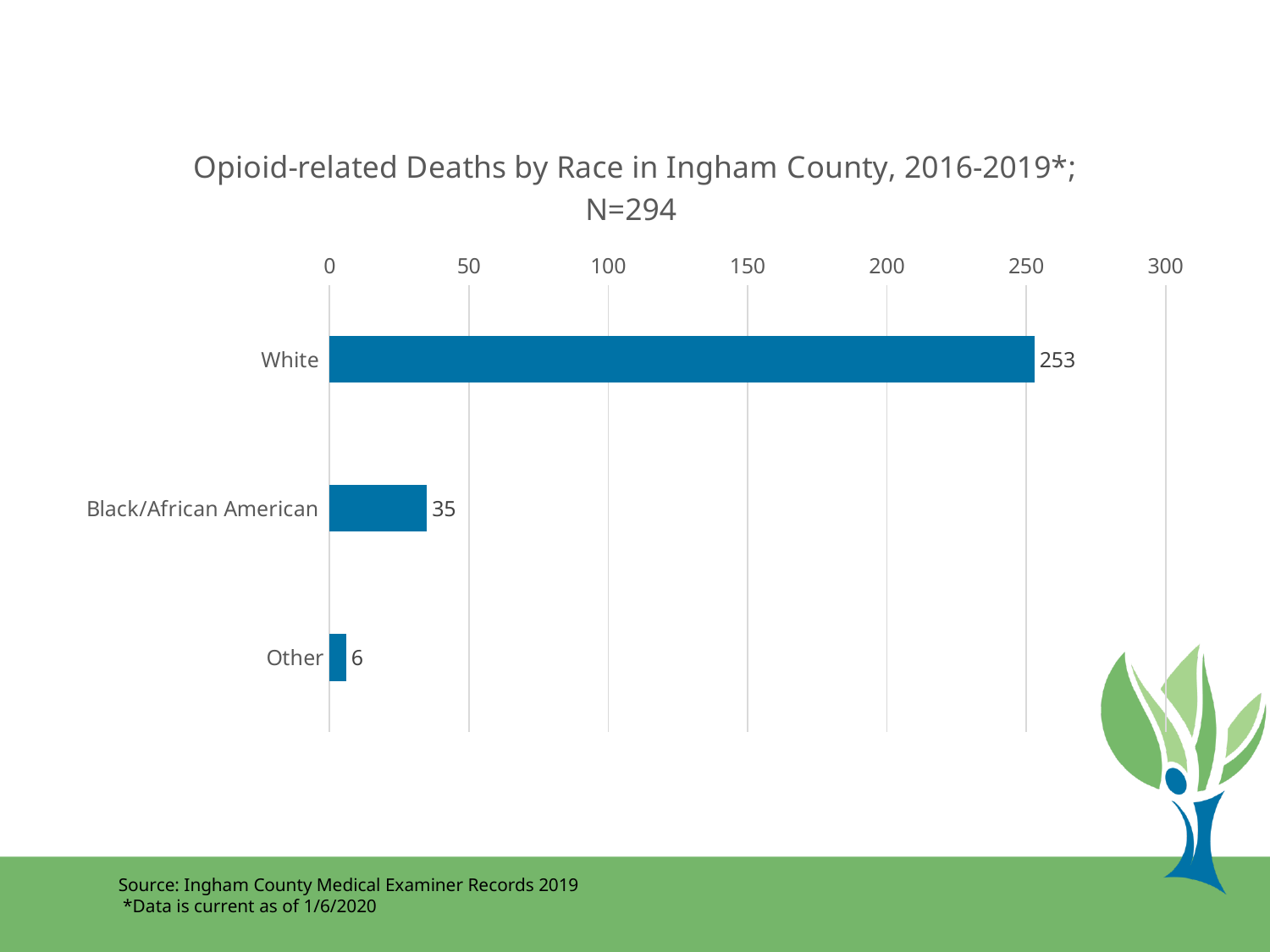
What is the value for Black/African American? 35 What is the title of the chart? Opioid-related Deaths by Race in Ingham County, 2016-2019*; N=294 What kind of chart is shown on the slide? Bar chart Which is larger, the value for Black/African American or the value for Other? Black/African American What is the difference between the values for Black/African American and Other? 29 Is the value for White greater or less than 200? greater Which category has the highest number of opioid-related deaths? White What is the difference between the values for White and Black/African American? 218 What is the value for Other? 6 Which category has the lowest number of opioid-related deaths? Other What is the value for White? 253 How many categories are shown in the chart? 3